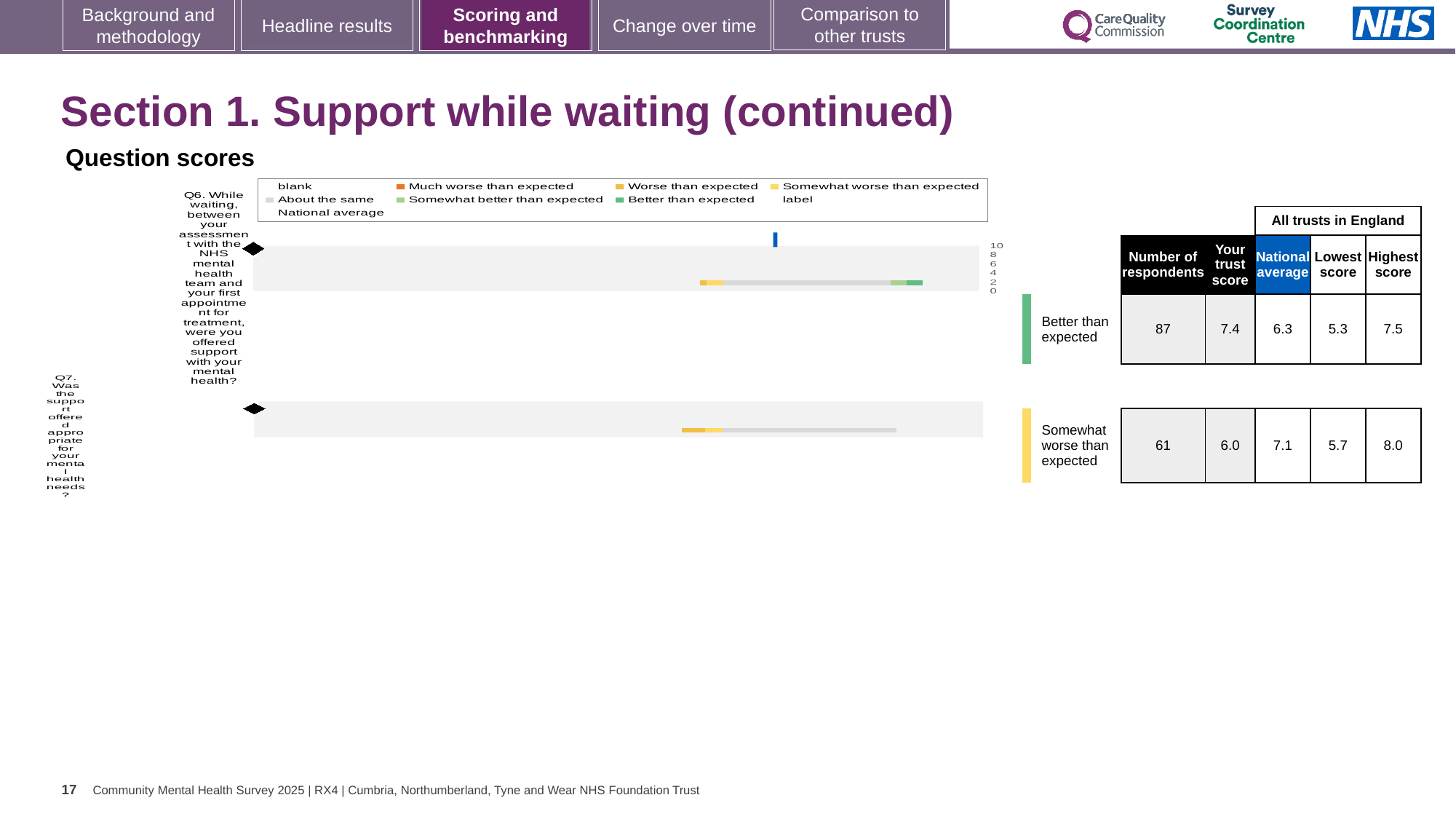
For Q6, what is the national average score? 6.3 For Q7 (was the support offered appropriate), what is the trust's score? 6.0 For Q7, which is larger: the trust's score or the national average? national average Which benchmark category is the trust's Q6 score placed in? Better than expected For Q6, what is the highest score among all trusts in England? 7.5 For Q6, how much higher is the trust's score than the national average? 1.1 What kind of chart is used to show the question scores on this slide? bar chart For Q7, what is the lowest score among all trusts in England? 5.7 For Q6 (support with your mental health while waiting), what is the trust's score? 7.4 How many questions (Q6 and Q7) are plotted on this slide? 2 Which benchmark category is the trust's Q7 score placed in? Somewhat worse than expected For Q7, how many respondents answered? 61